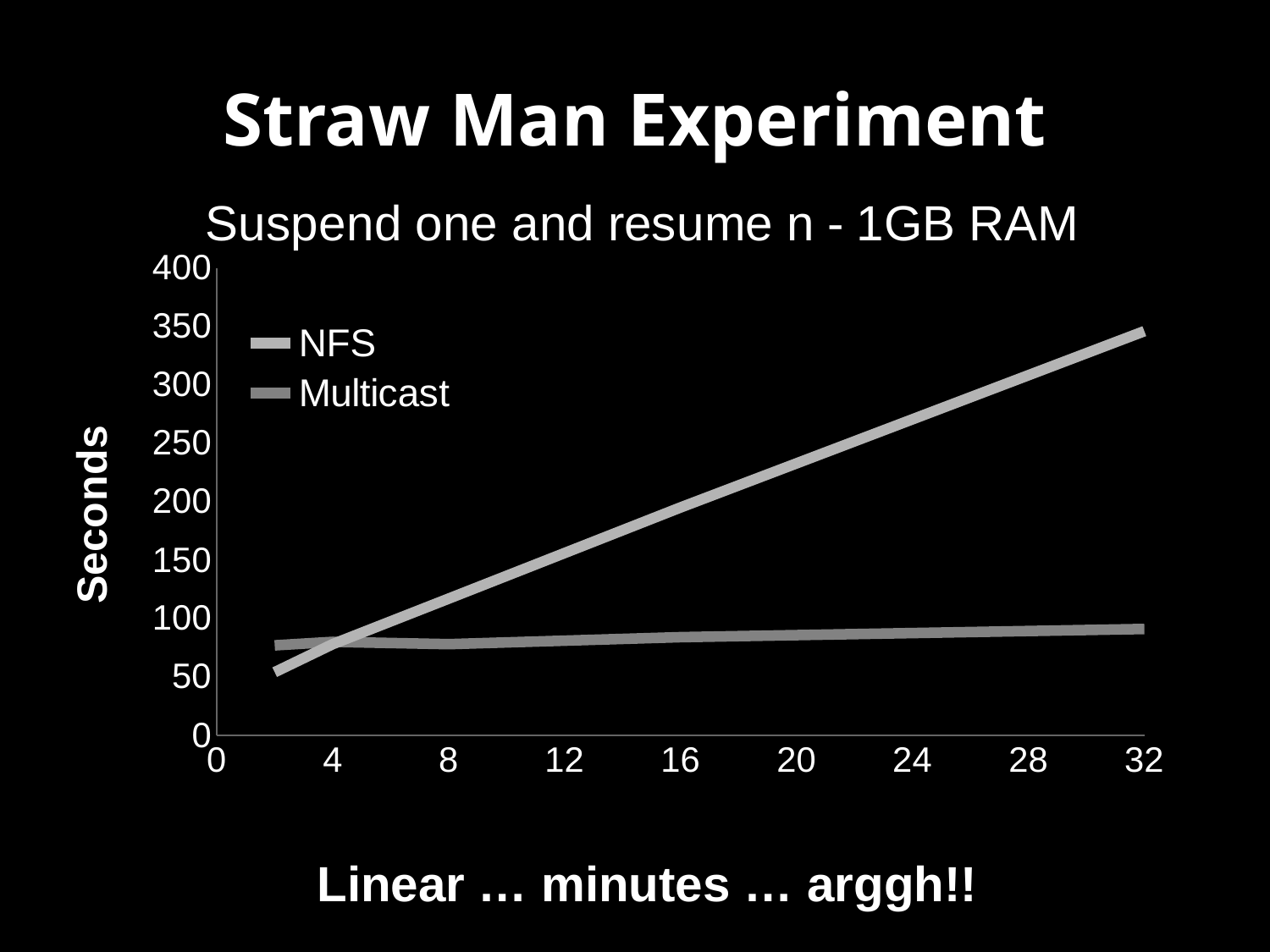
Does the NFS line rise or fall as the x-axis value increases? rise How many series does the chart's legend list? 2 Is the NFS value at x = 16 greater or less than 250? less What kind of chart is shown on the slide? line chart What is the title of the chart? Suspend one and resume n - 1GB RAM What are the two series named in the chart's legend? NFS and Multicast Is the NFS value at x = 32 greater or less than 300? greater Is the Multicast value at x = 16 greater or less than 50? greater At x = 32, which series has the larger value, NFS or Multicast? NFS At x = 24, which series has the smaller value, NFS or Multicast? Multicast